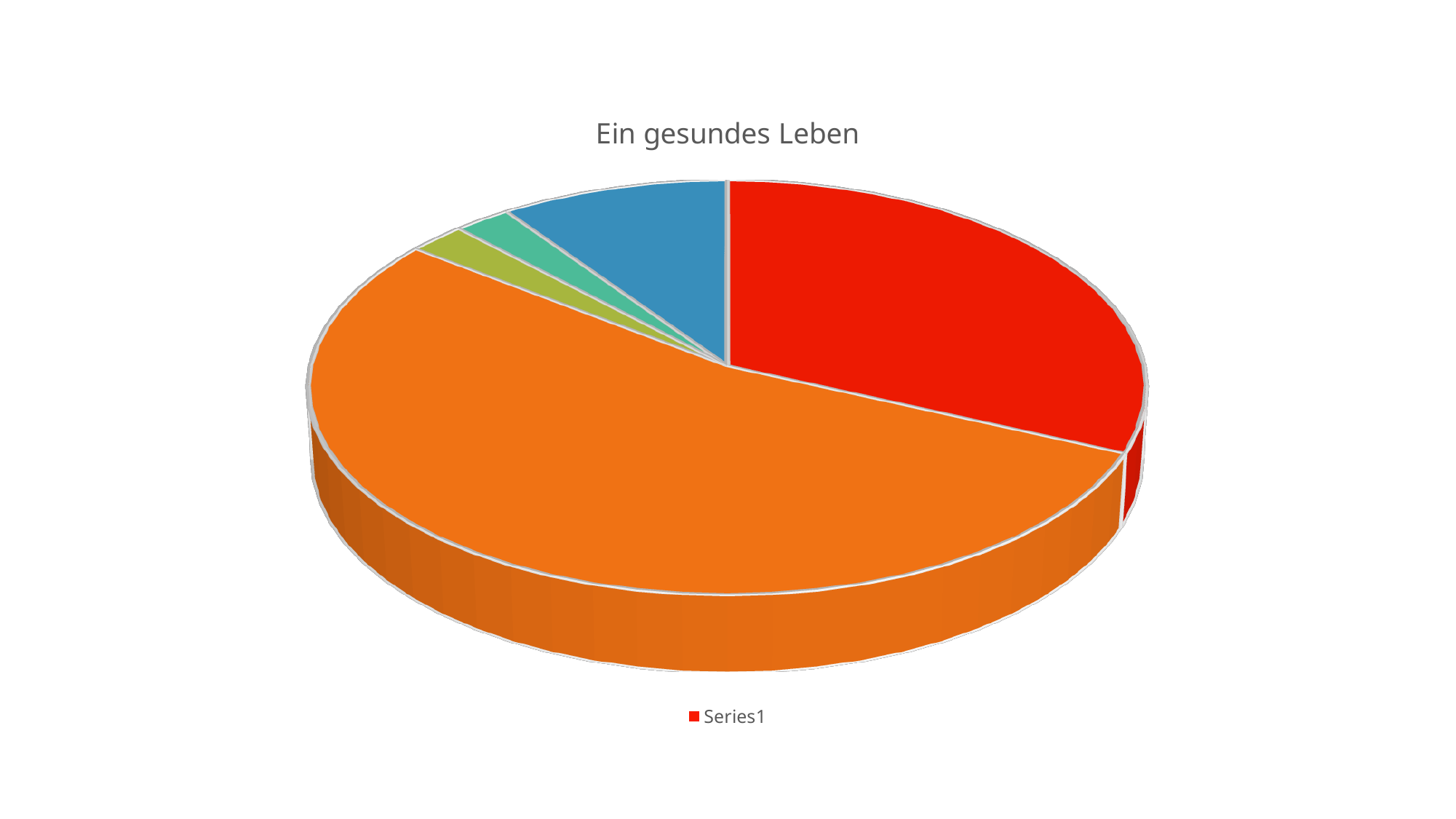
What is the name of the series shown in the legend? Series1 What is the title of the chart? Ein gesundes Leben Which colour slice is the largest in the pie chart? orange Which slice is larger, the red slice or the blue slice? red How many slices does the pie chart have? 5 How many series does the legend list? 1 Which slice is larger, the orange slice or the red slice? orange What kind of chart is shown on the slide? pie chart